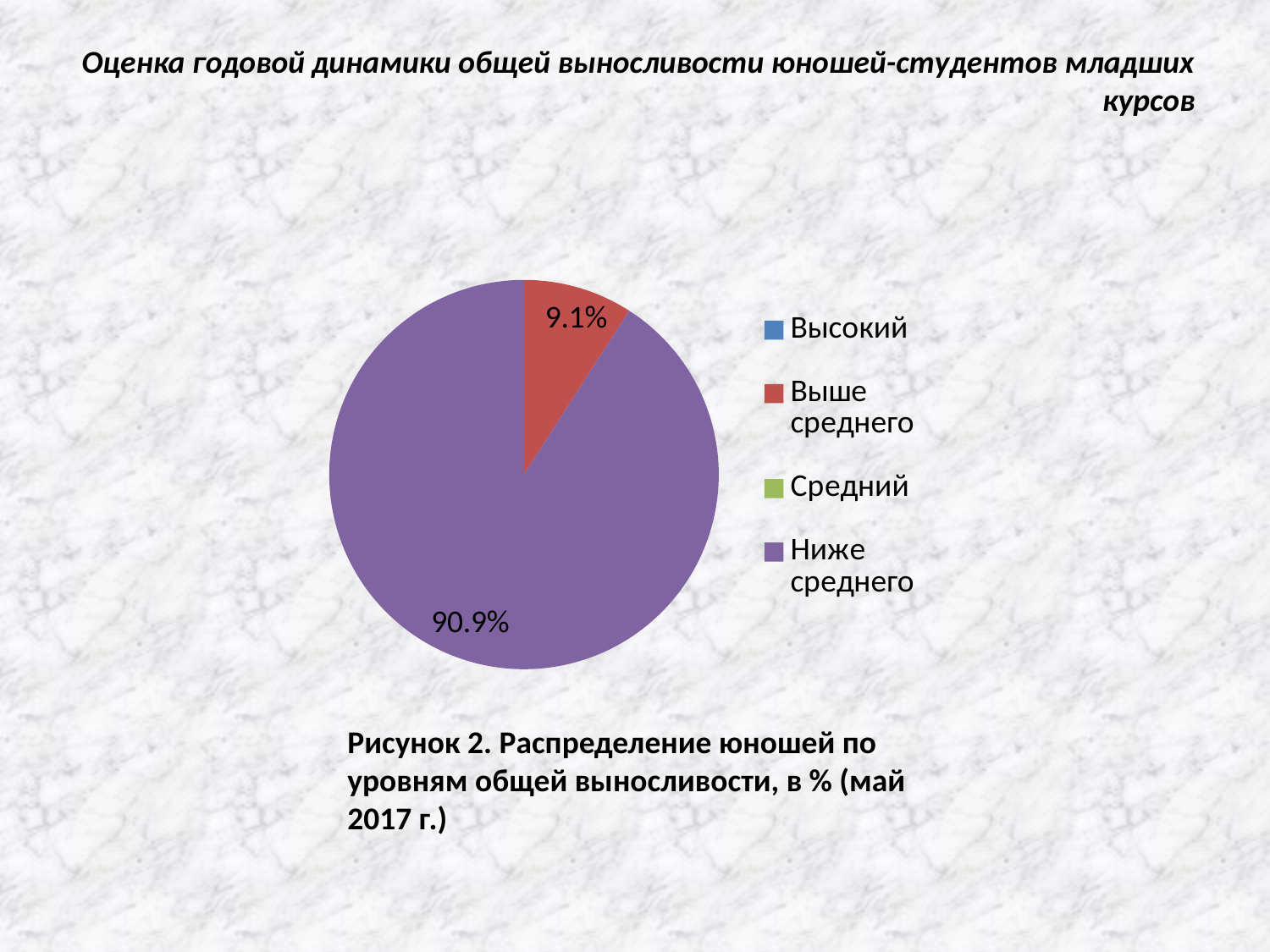
Which category has the largest slice of the pie? Ниже среднего What kind of chart is shown on the slide? pie chart What colour is the "Ниже среднего" slice? purple How many slices are visible in the pie? 2 Is the share for "Выше среднего" greater or less than 10%? less Is the share for "Ниже среднего" greater or less than 50%? greater What is the difference in percentage points between the "Ниже среднего" and "Выше среднего" slices? 81.8 What share of the pie does the "Ниже среднего" slice take? 90.9% Which of the two visible slices is larger: "Выше среднего" or "Ниже среднего"? Ниже среднего How many categories does the legend list? 4 What share of the pie does the "Выше среднего" slice take? 9.1% What colour is the "Выше среднего" slice? red